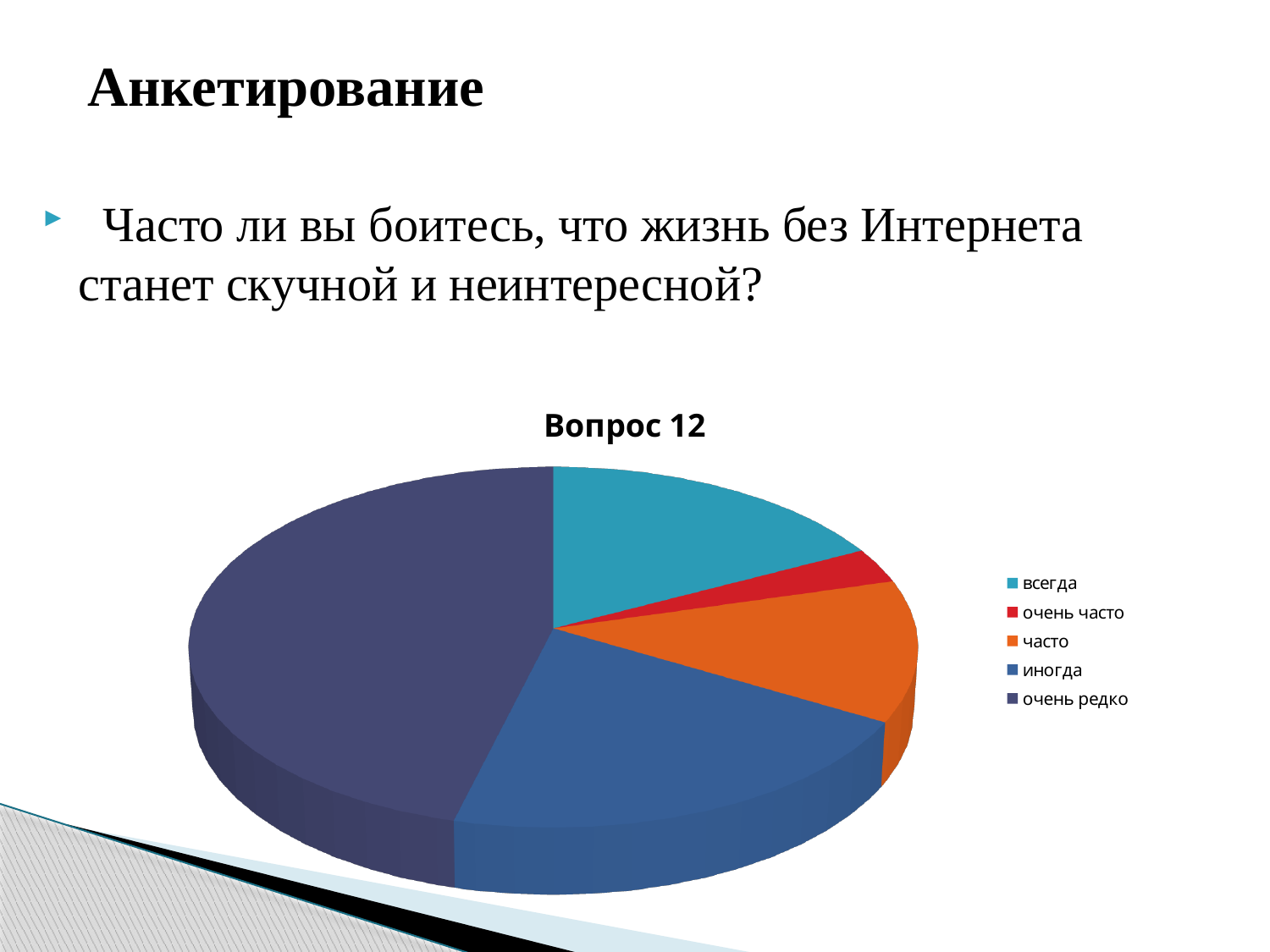
Which category has the largest slice of the pie? очень редко Which category is shown in red in the chart? очень часто Which slice is larger: иногда or всегда? иногда How many categories does the legend of the chart list? 5 Which slice is larger: иногда or часто? иногда What kind of chart is shown on the slide? pie chart What is the title of the chart? Вопрос 12 Which category has the smallest slice of the pie? очень часто Which slice is larger: часто or очень часто? часто